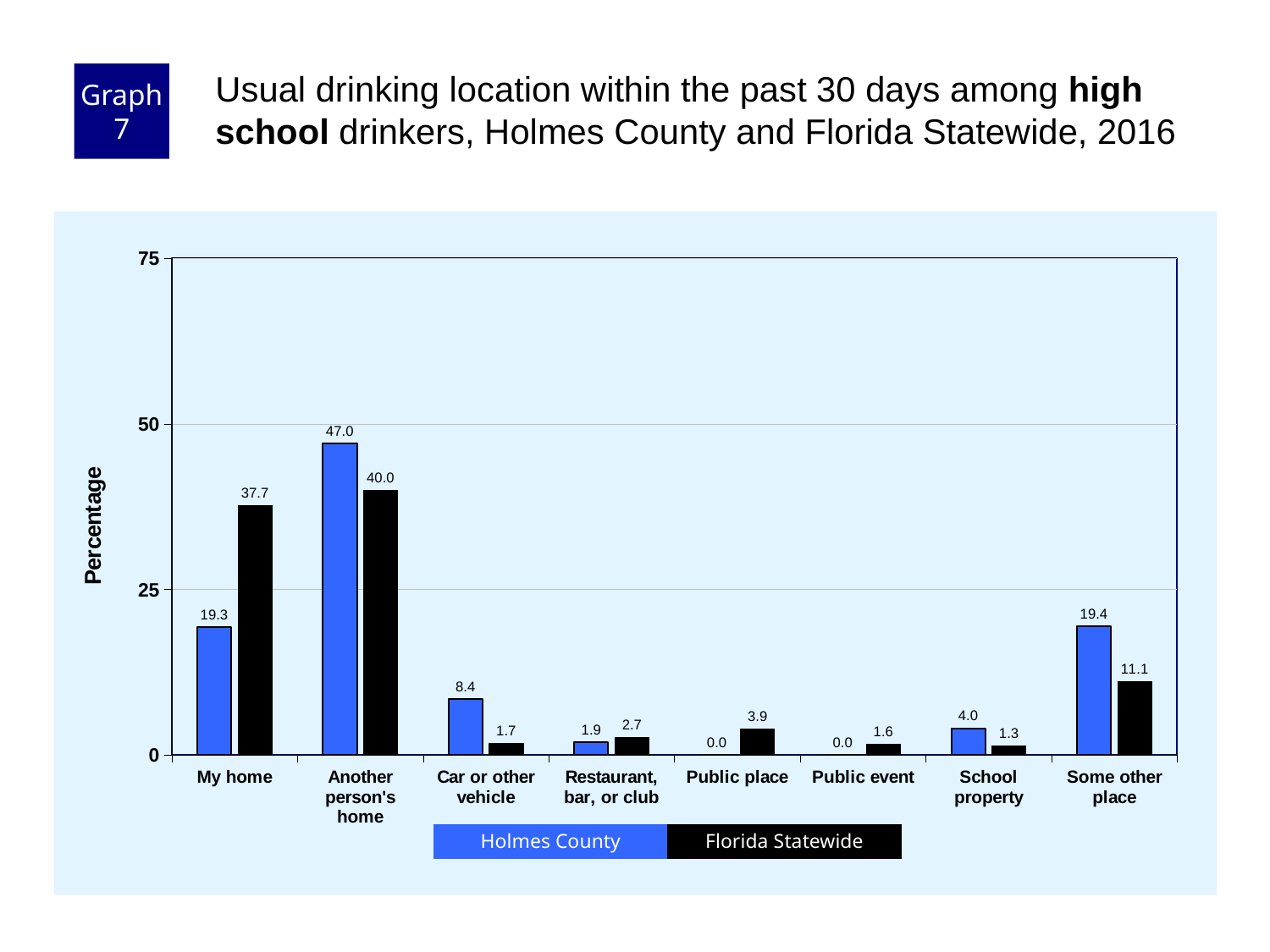
What is the label of the y axis? Percentage What is the Holmes County value for "Car or other vehicle"? 8.4 Which category has the lowest Florida Statewide value? School property How many categories are shown on the x axis? 8 Is the Florida Statewide value for "Another person's home" greater or less than 25? greater Which is larger for "Restaurant, bar, or club": Holmes County or Florida Statewide? Florida Statewide How many series does the legend list? 2 What is the Florida Statewide value for "My home"? 37.7 What is the Holmes County value for "Another person's home"? 47.0 What kind of chart is shown on the slide? Bar chart What is the difference between the Holmes County and Florida Statewide values for "Some other place"? 8.3 Which category has the highest Holmes County value? Another person's home